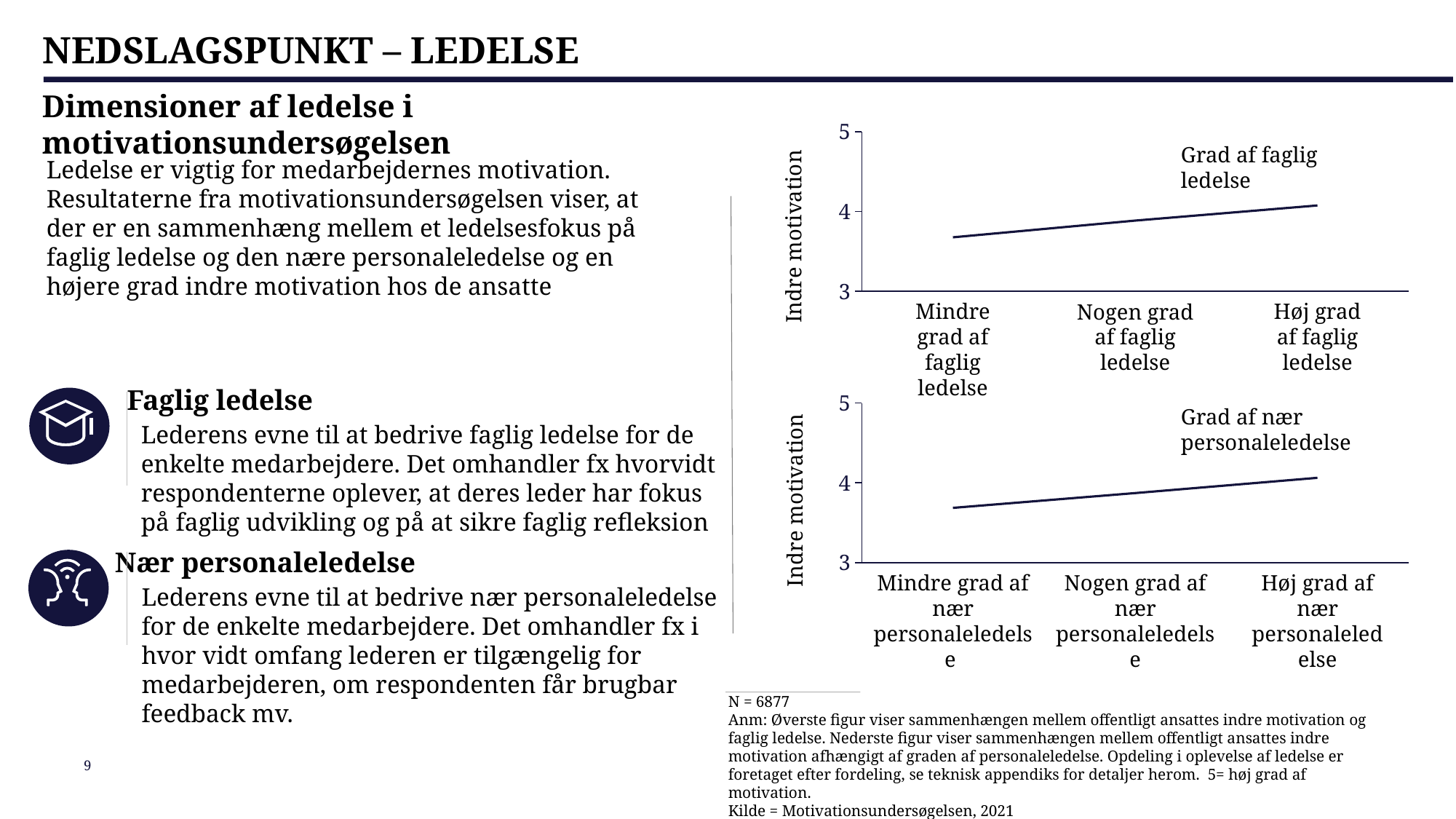
In the bottom chart (Grad af nær personaleledelse), is the value for Mindre grad af nær personaleledelse greater or less than 4? less In the bottom chart (Grad af nær personaleledelse), how many categories are shown on the x axis? 3 In the bottom chart (Grad af nær personaleledelse), which category has the lowest indre motivation? Mindre grad af nær personaleledelse In the top chart (Grad af faglig ledelse), which category has the highest indre motivation? Høj grad af faglig ledelse In the bottom chart (Grad af nær personaleledelse), do the values rise or fall from left to right along the x axis? rise What kind of chart is the top chart (Grad af faglig ledelse)? line chart In the top chart (Grad af faglig ledelse), how many categories are shown on the x axis? 3 What kind of chart is the bottom chart (Grad af nær personaleledelse)? line chart What is the label on the y axis of the top chart (Grad af faglig ledelse)? Indre motivation In the bottom chart (Grad af nær personaleledelse), which is larger: the value for Høj grad af nær personaleledelse or for Mindre grad af nær personaleledelse? Høj grad af nær personaleledelse In the top chart (Grad af faglig ledelse), is the value for Mindre grad af faglig ledelse greater or less than 4? less In the top chart (Grad af faglig ledelse), do the values rise or fall from left to right along the x axis? rise